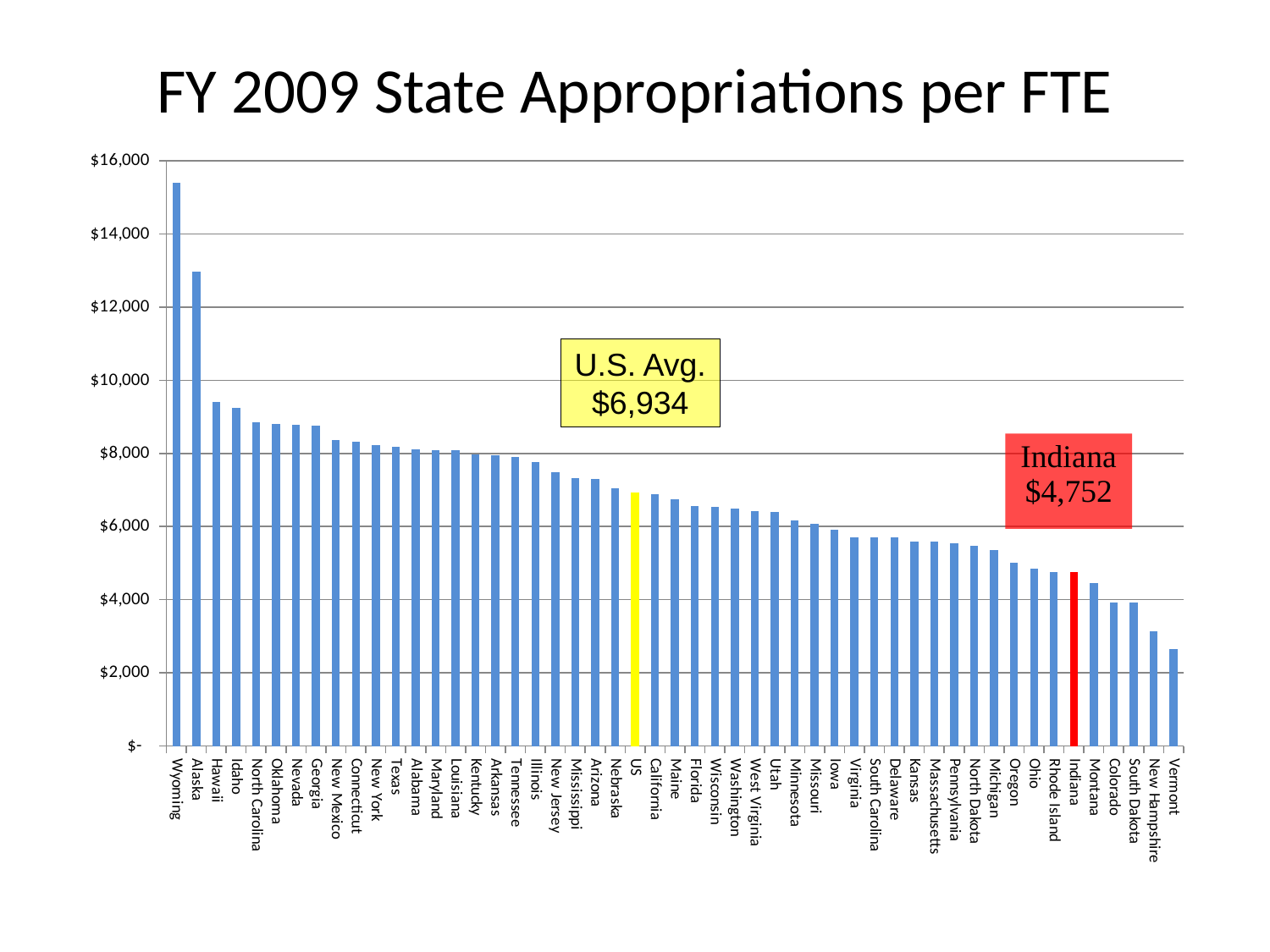
What is the difference between the U.S. average and Indiana's value? $2,182 Is the value for Wyoming greater or less than $14,000? greater Which state has the highest appropriation per FTE? Wyoming Do the values rise or fall moving from left to right along the x axis? fall What is the title of the chart? FY 2009 State Appropriations per FTE Which state has the lowest appropriation per FTE? Vermont Which is larger, the value for Wyoming or the value for Alaska? Wyoming Is the value for Hawaii greater or less than $8,000? greater What is the value for Indiana? $4,752 What is the U.S. average state appropriation per FTE shown on the chart? $6,934 Is the value for Vermont greater or less than $4,000? less What type of chart is shown on the slide? bar chart